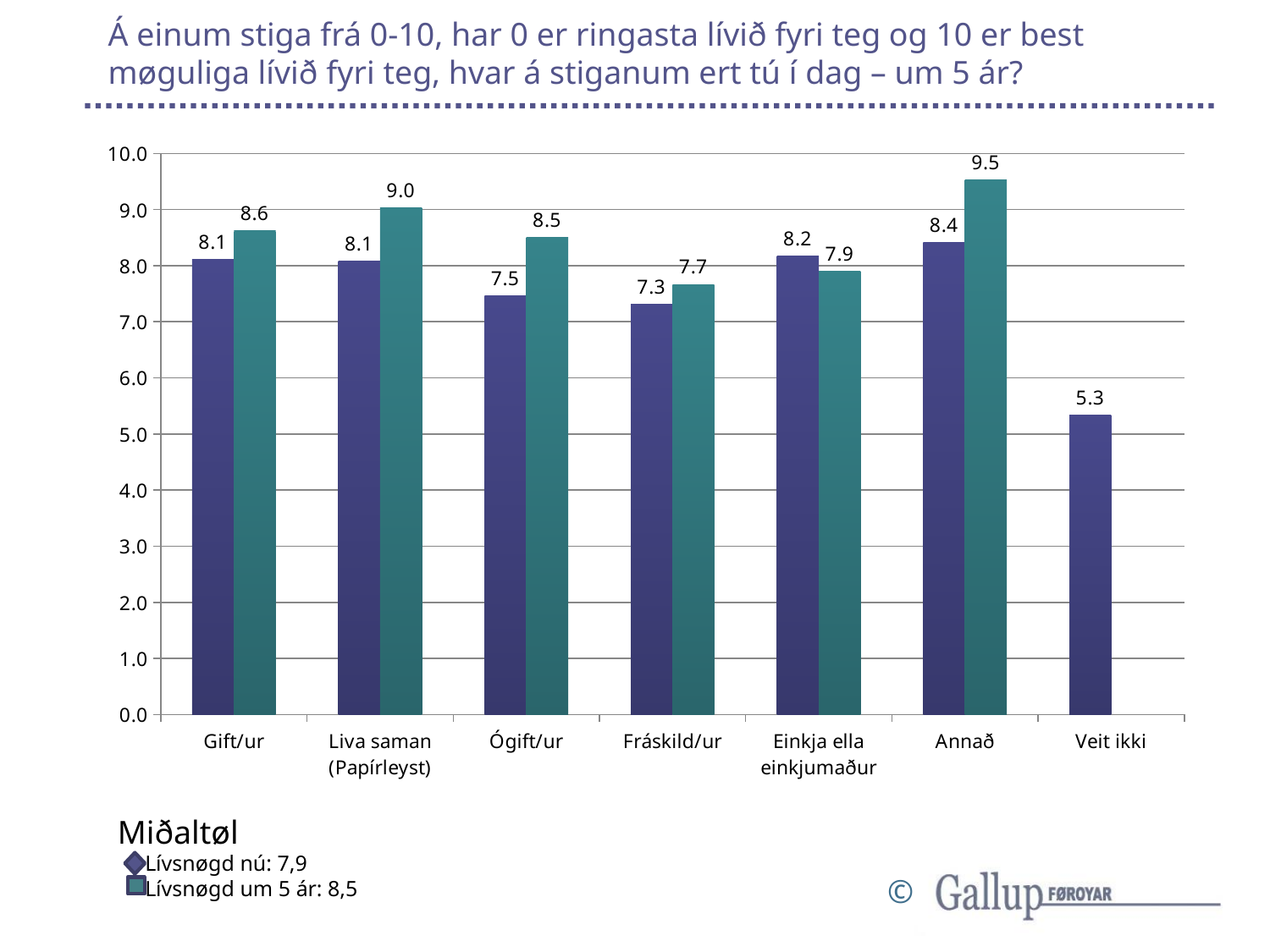
What is the value for Veit ikki? 5.3 What is the average (Miðaltøl) given for Lívsnøgd um 5 ár in the legend? 8,5 What is the value for Annað in the Lívsnøgd um 5 ár series? 9.5 What is the value for Gift/ur in the Lívsnøgd nú series? 8.1 What is the difference between the Lívsnøgd um 5 ár and Lívsnøgd nú values for Ógift/ur? 1.0 Which category has the lowest value in the Lívsnøgd nú series? Veit ikki How many categories are shown on the x axis? 7 Which category has the highest value in the Lívsnøgd um 5 ár series? Annað What kind of chart is shown on the slide? bar chart Is the value for Veit ikki greater or less than 6.0? less How many series does the legend list? 2 For Einkja ella einkjumaður, which is larger: the Lívsnøgd nú value or the Lívsnøgd um 5 ár value? Lívsnøgd nú